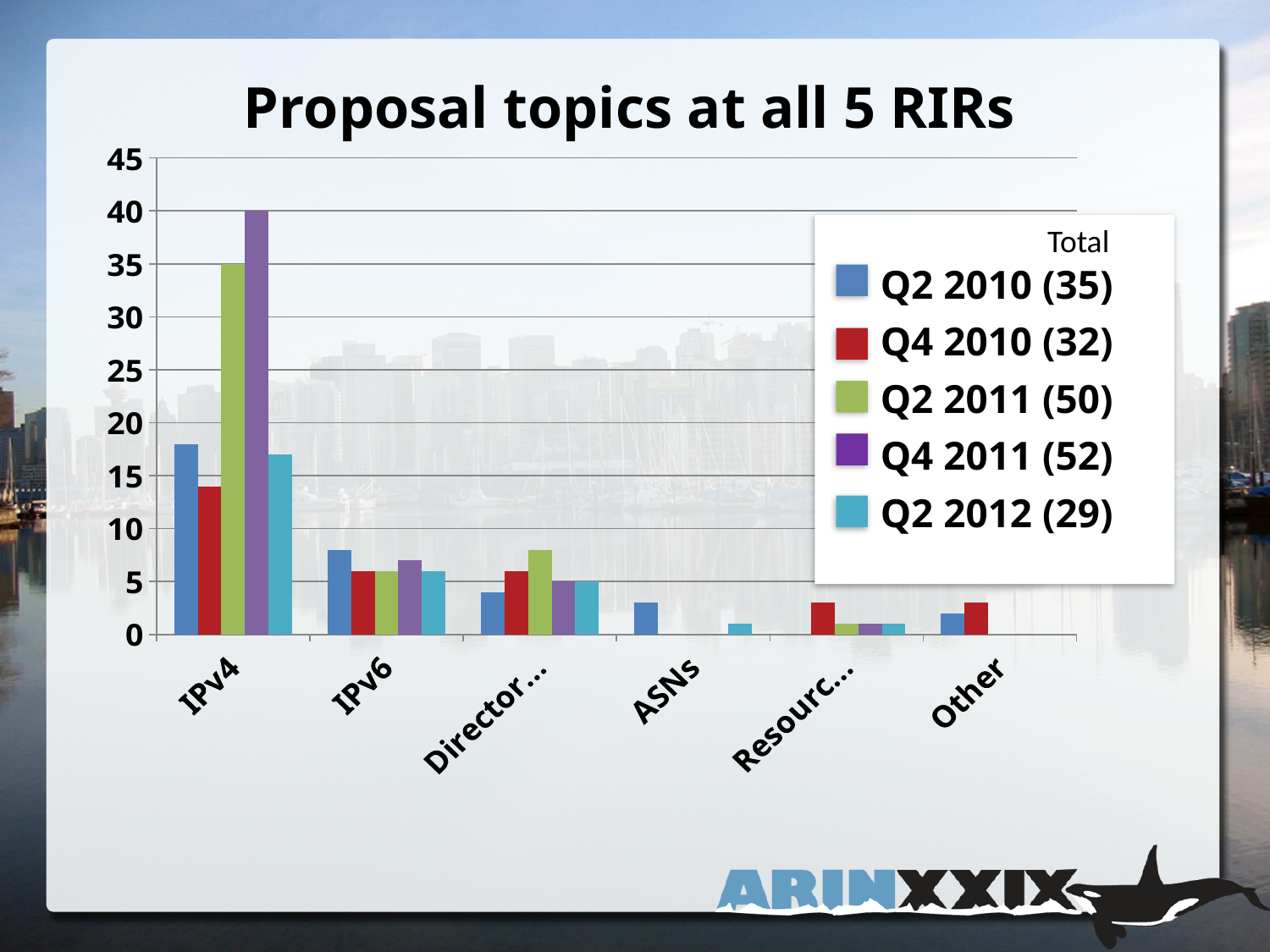
Which category has the highest value for the Q4 2011 series? IPv4 What is the value for IPv4 in the Q4 2011 series? 40 According to the legend, which series has the highest total? Q4 2011 (52) For IPv6, which series has the larger value: Q2 2010 or Q4 2010? Q2 2010 How many series does the legend list? 5 According to the legend, what is the total for the Q2 2011 series? 50 For IPv4, which series has the larger value: Q2 2011 or Q4 2011? Q4 2011 Is the value for IPv4 in the Q2 2012 series greater or less than 20? less What is the value for IPv4 in the Q2 2011 series? 35 Is the value for IPv4 in the Q2 2010 series greater or less than 15? greater What kind of chart is shown on the slide? bar chart How many categories are shown along the x axis? 6